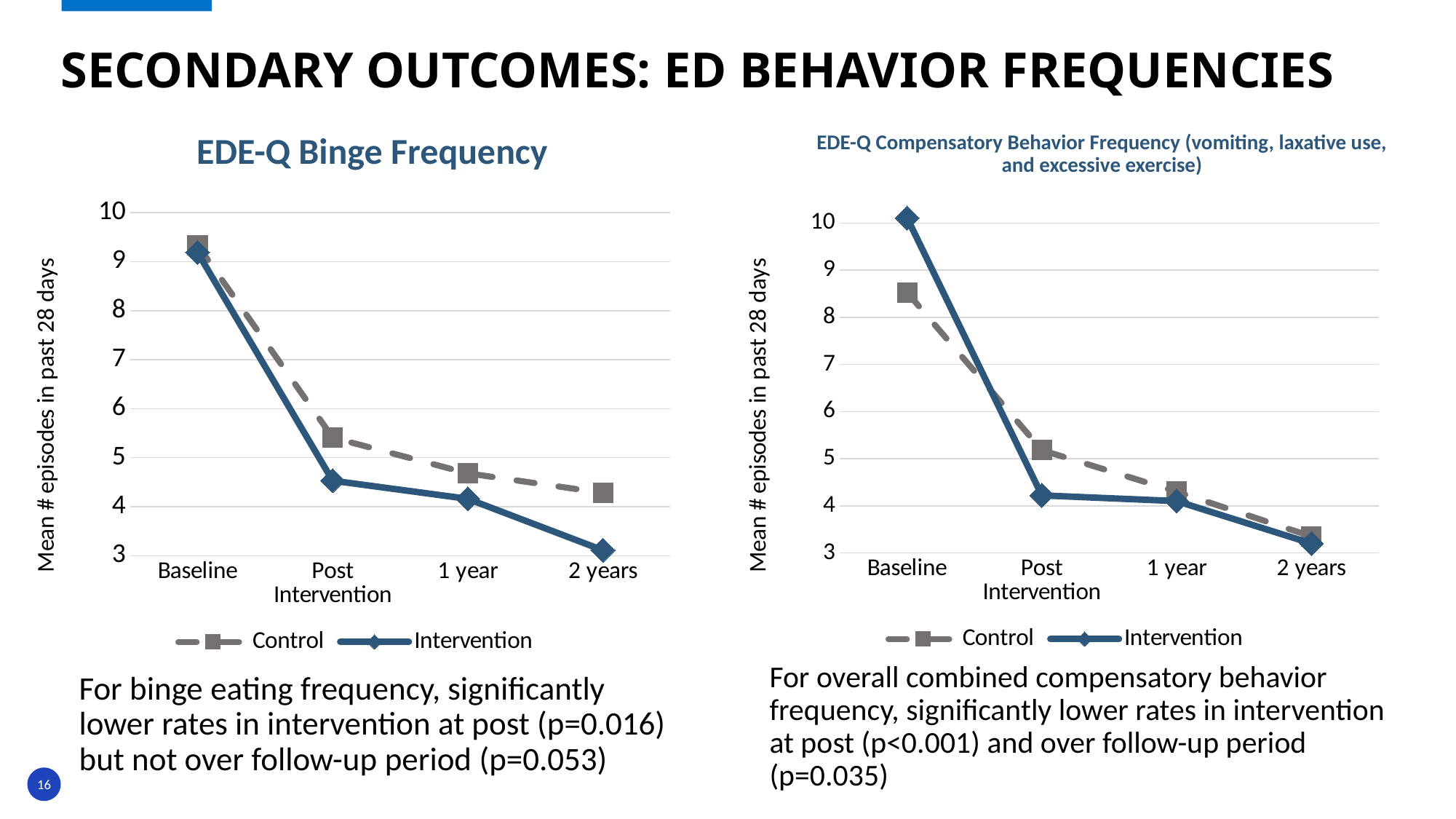
In the EDE-Q Binge Frequency chart, at which time point is the Intervention value lowest? 2 years How many series does the legend of the EDE-Q Binge Frequency chart list? 2 In the EDE-Q Binge Frequency chart, is the Control value at Post Intervention greater or less than 5? greater In the EDE-Q Compensatory Behavior Frequency chart, is the Intervention value at Baseline greater or less than 9? greater In the EDE-Q Binge Frequency chart, do the Intervention values rise or fall from Baseline to 2 years? Fall What are the two legend entries shown for the EDE-Q Compensatory Behavior Frequency chart? Control and Intervention What kind of chart is the EDE-Q Binge Frequency chart on the left? Line chart In the EDE-Q Binge Frequency chart, which series has the higher value at Post Intervention, Control or Intervention? Control In the EDE-Q Binge Frequency chart, is the Intervention value at 2 years greater or less than 4? less How many time points are plotted along the x axis of the EDE-Q Binge Frequency chart? 4 In the EDE-Q Compensatory Behavior Frequency chart, which series has the higher value at Baseline, Control or Intervention? Intervention In the EDE-Q Compensatory Behavior Frequency chart on the right, at which time point is the Intervention value highest? Baseline